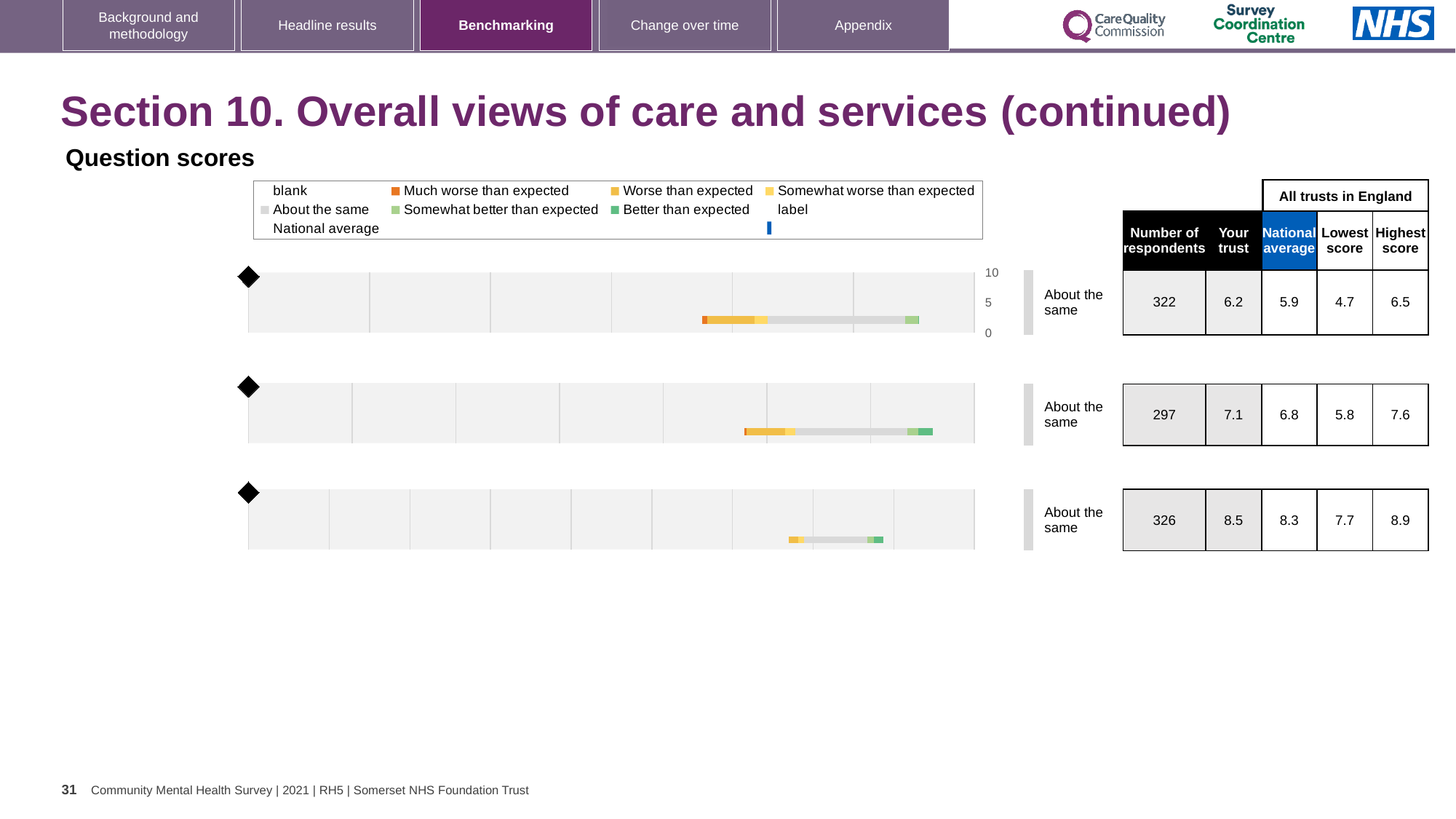
Which of the three charts has the highest Your trust score? The bottom chart How many charts are shown on the slide? 3 On the bottom chart, what is the Highest score among all trusts in England? 8.9 On the bottom chart, which is larger: the Your trust score or the National average? Your trust On the top chart, what is the score for Your trust? 6.2 On the top chart, what is the Lowest score among all trusts in England? 4.7 On the top chart, what is the National average score? 5.9 On the top chart, how much higher is the Your trust score than the National average? 0.3 What benchmark category is shown next to the middle chart? About the same On the middle chart, what is the difference between the Highest score and the Lowest score? 1.8 On the middle chart, how many respondents are there? 297 What kind of chart is used on this slide? Bar chart